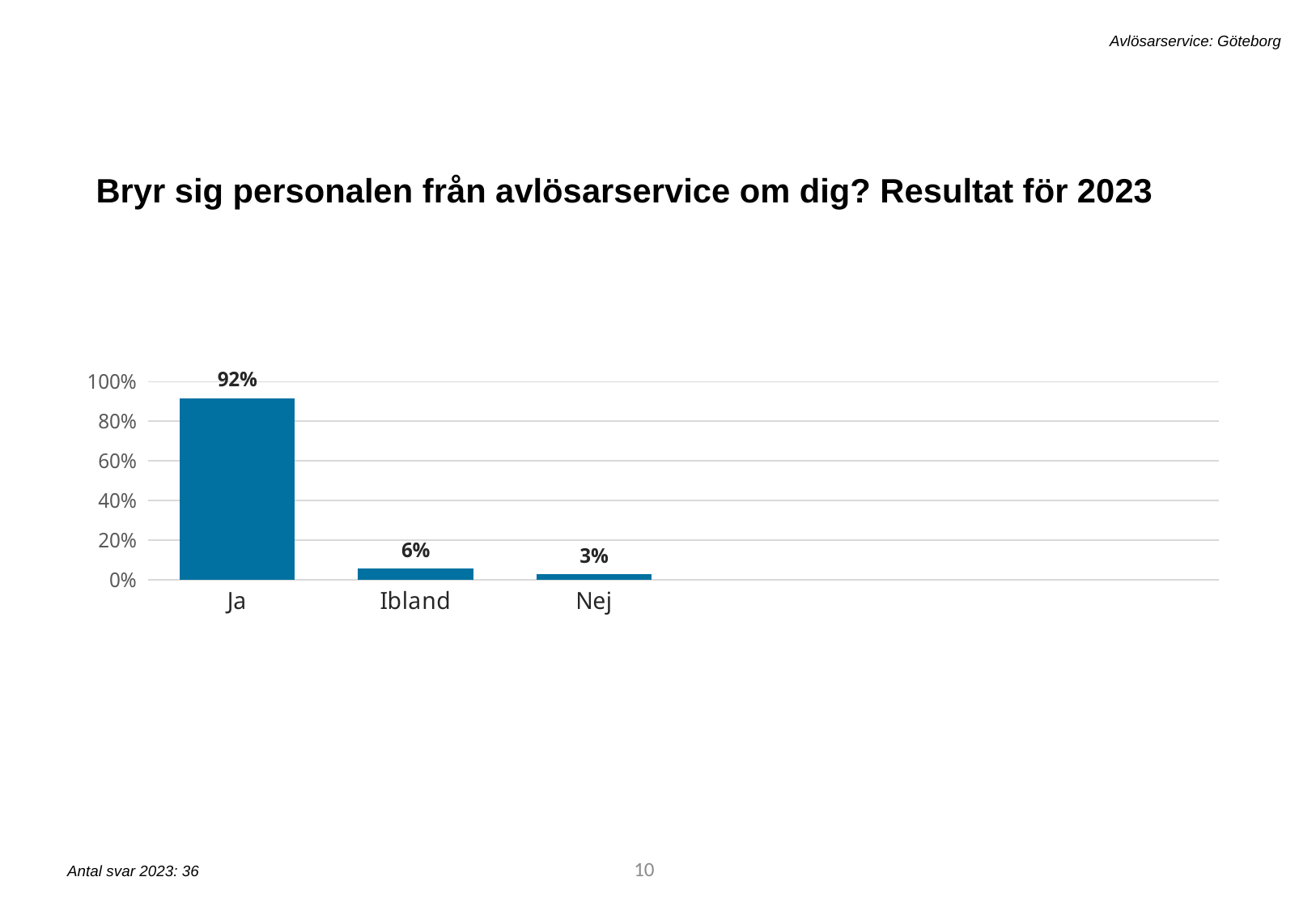
What is the difference between the values for Ibland and Nej? 3% Which category has the highest value? Ja Which is larger, the value for Ibland or the value for Nej? Ibland How many categories are shown on the x axis? 3 What is the value for Nej? 3% What is the value for Ibland? 6% What is the title of the chart? Bryr sig personalen från avlösarservice om dig? Resultat för 2023 What kind of chart is shown on the slide? bar chart Which category has the lowest value? Nej What is the value for Ja? 92% Is the value for Ja greater or less than 80%? greater What is the difference between the values for Ja and Ibland? 86%